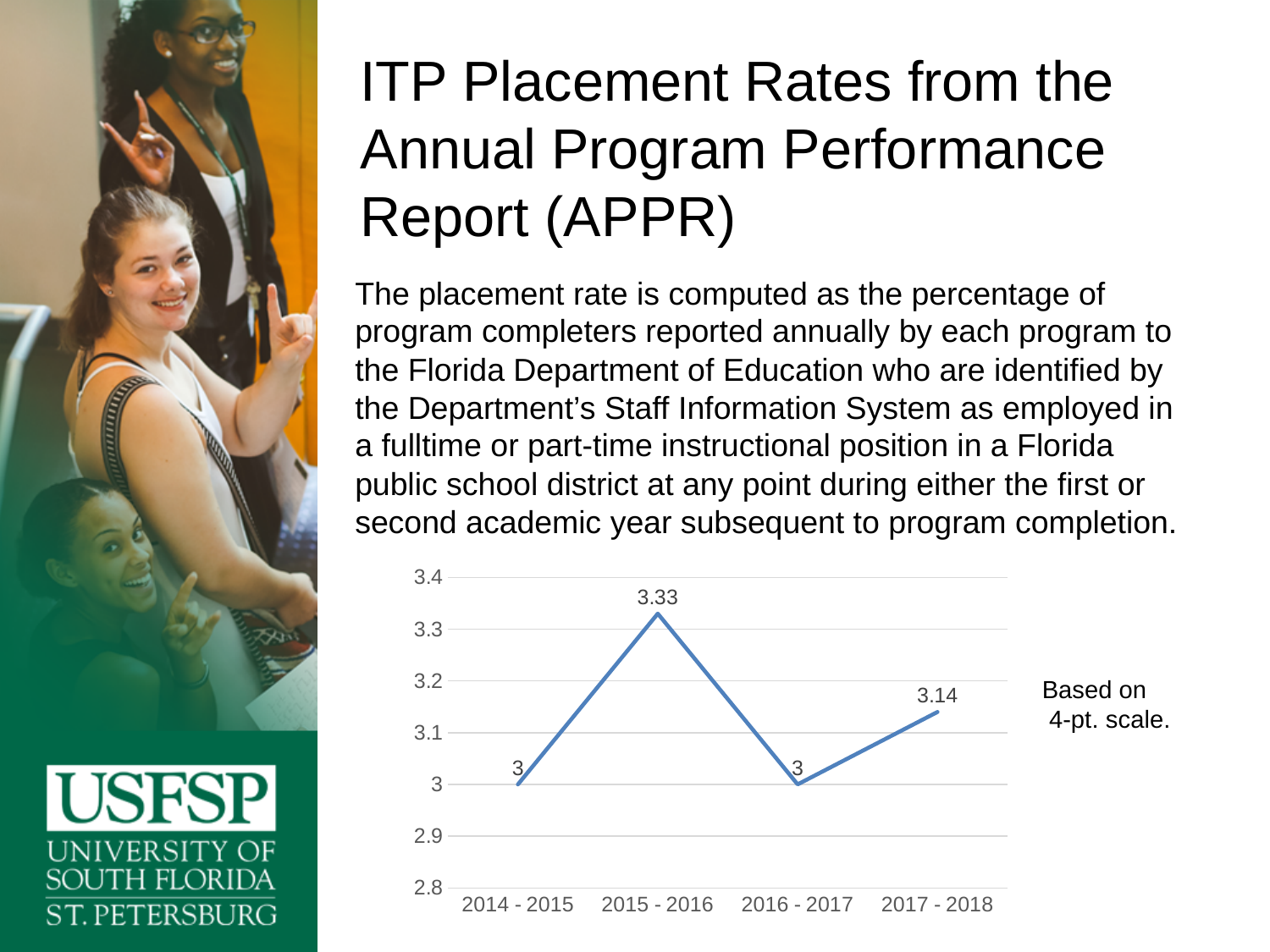
What is the difference between the values for 2015 - 2016 and 2017 - 2018? 0.19 Which is larger, the value for 2017 - 2018 or the value for 2016 - 2017? 2017 - 2018 What kind of chart is shown on the slide? line chart What is the difference between the values for 2015 - 2016 and 2016 - 2017? 0.33 According to the note beside the chart, what scale are the values based on? 4-pt. scale How many periods are plotted on the x axis? 4 What is the value for 2017 - 2018? 3.14 What is the value for 2015 - 2016? 3.33 What is the value for 2014 - 2015? 3 Is the value for 2015 - 2016 greater or less than 3.2? greater Does the value rise or fall from 2016 - 2017 to 2017 - 2018? rise Which period has the highest value? 2015 - 2016